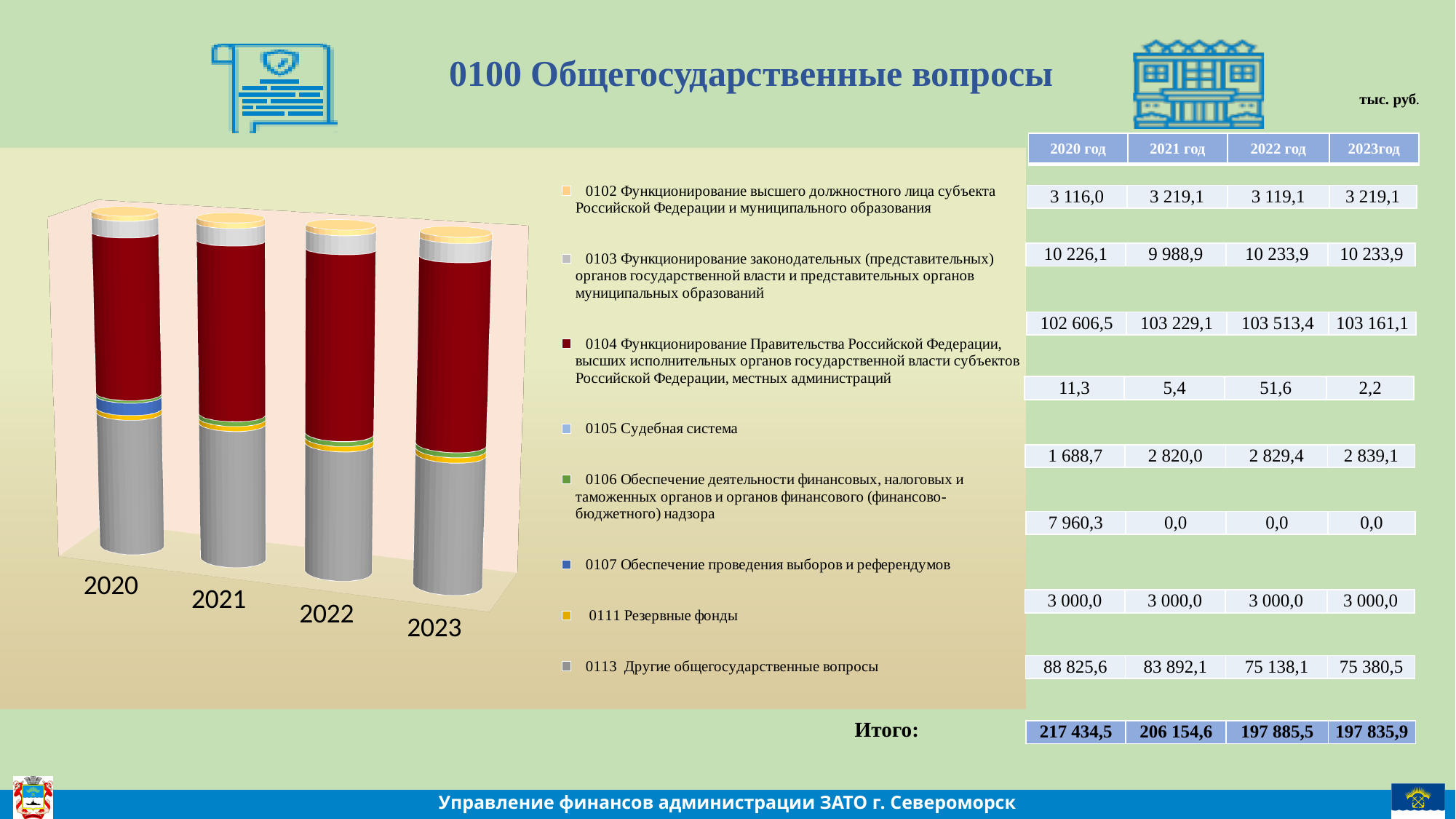
How many series does the chart legend list? 8 What is the total of the stacked bar for 2020 (Итого)? 217 434,5 How many years (categories) are plotted along the x axis of the chart? 4 What is the value for series 0104 (Функционирование Правительства Российской Федерации...) in 2022? 103 513,4 What is the value for series 0113 (Другие общегосударственные вопросы) in 2020? 88 825,6 What is the value for series 0107 (Обеспечение проведения выборов и референдумов) in 2021? 0,0 In what units are the chart values given, according to the slide? тыс. руб. Which year has the larger value for series 0103: 2020 or 2021? 2020 Which year has the highest total (Итого)? 2020 Which year has the lowest total (Итого)? 2023 What kind of chart is shown on the slide? Stacked bar chart What is the difference between the 0113 values for 2020 and 2023? 13 445,1